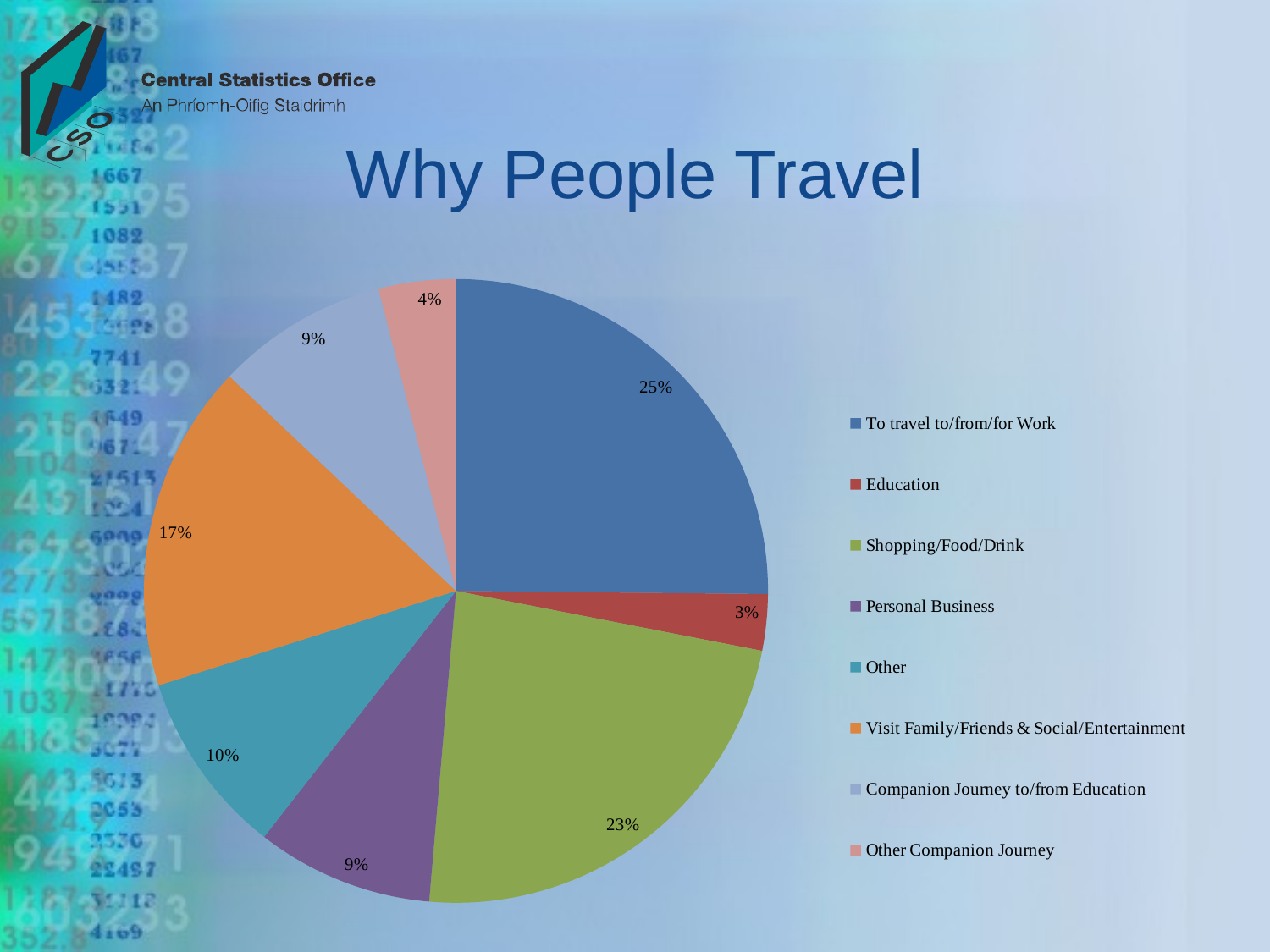
What is the difference in percentage points between 'To travel to/from/for Work' and 'Shopping/Food/Drink'? 2 percentage points How many categories does the legend list? 8 What type of chart is shown on the slide? Pie chart What share of the pie is 'Education'? 3% Which category has the smallest share of the pie? Education What share of the pie is 'Shopping/Food/Drink'? 23% What share of the pie is 'Visit Family/Friends & Social/Entertainment'? 17% Which is larger, the share for 'Other' or the share for 'Personal Business'? Other Which category has the largest share of the pie? To travel to/from/for Work What is the title of the chart? Why People Travel